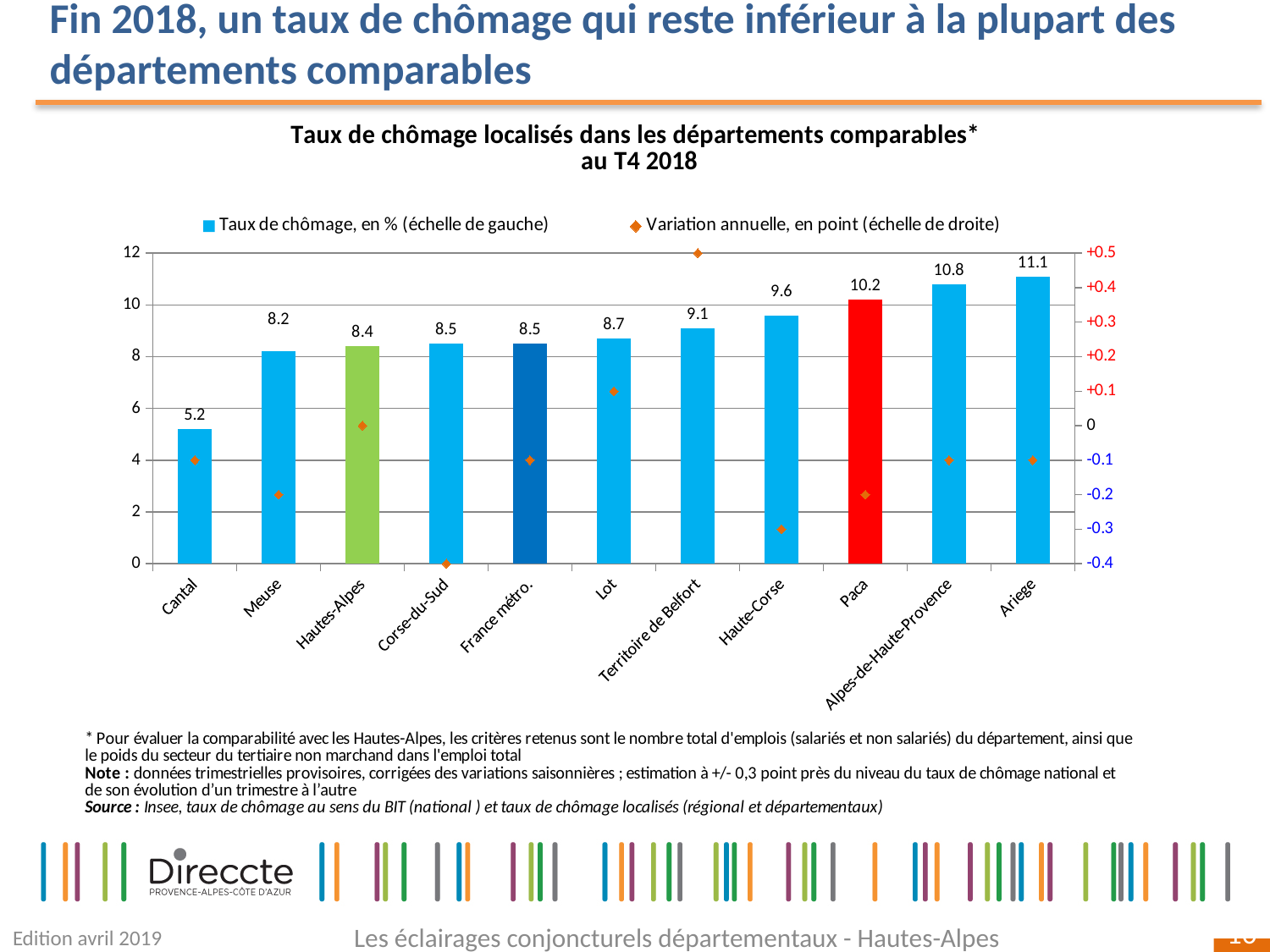
What is the unemployment rate shown for Paca? 10.2 What is the unemployment rate (taux de chômage) shown for Hautes-Alpes? 8.4 Do the unemployment rate values rise or fall from left to right along the x axis? Rise Which has a higher unemployment rate, Haute-Corse or Lot? Haute-Corse Which department has the highest unemployment rate on the chart? Ariege What is the difference between the unemployment rates of Ariege and Cantal? 5.9 How many categories (bars) are shown on the x axis? 11 How many series does the legend list? 2 What is the unemployment rate shown for Cantal? 5.2 What type of chart is used for the unemployment rate series? Bar chart Which department has the lowest unemployment rate on the chart? Cantal What is the annual variation (variation annuelle) shown for Territoire de Belfort on the right axis? +0.5